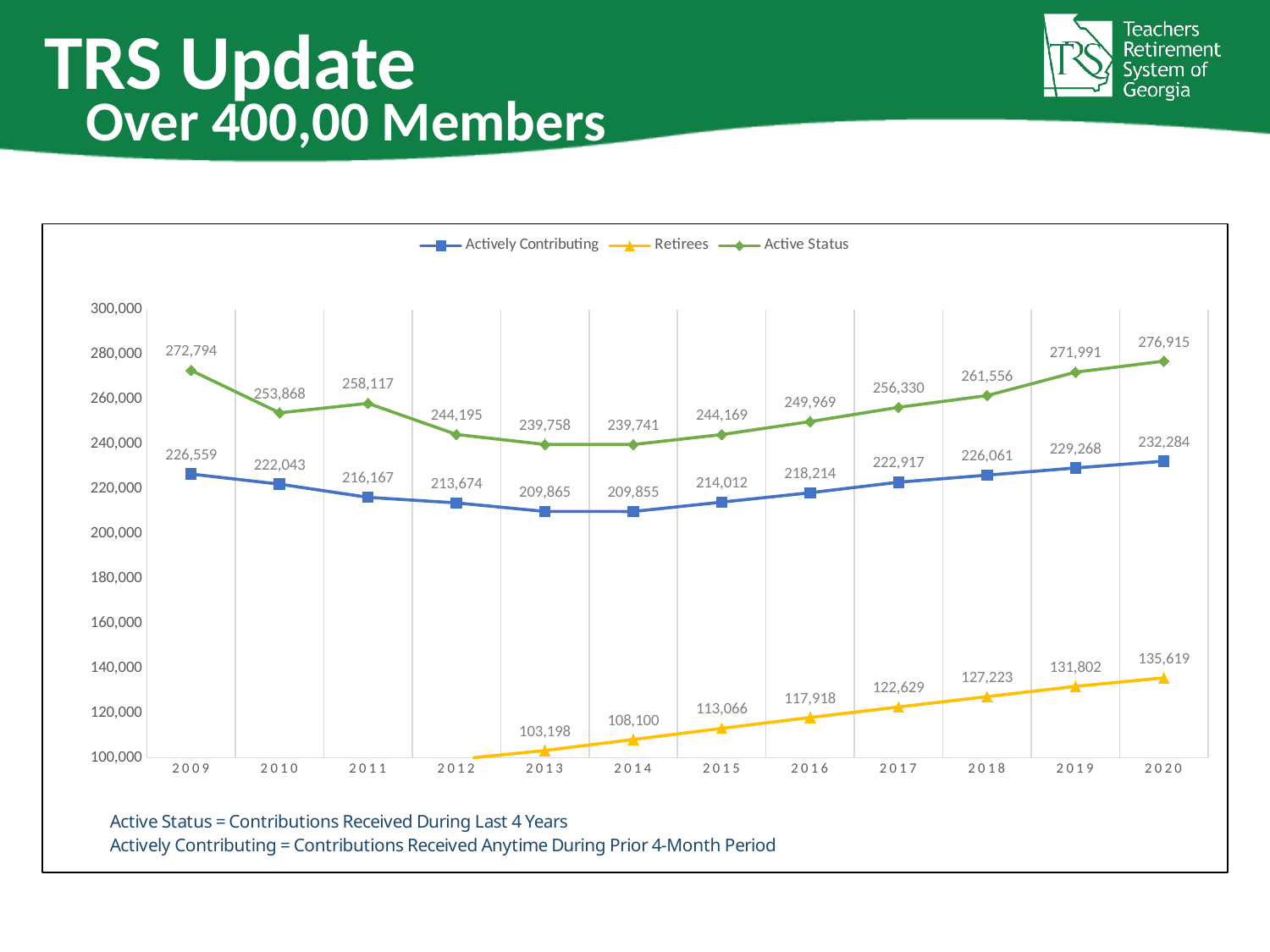
Does the Retirees series rise or fall from 2013 to 2020? Rise By how much did the Retirees value increase from 2013 to 2020? 32,421 In which labelled year is the Retirees series at its highest? 2020 What is the Active Status value for 2020? 276,915 How many series does the legend list? 3 How many years are shown on the x axis? 12 What kind of chart is shown on the slide? Line chart What is the Actively Contributing value for 2013? 209,865 What is the difference between the Active Status values for 2020 and 2009? 4,121 In which year is the Active Status series at its highest? 2020 Which year has the larger Actively Contributing value, 2009 or 2020? 2020 What is the Retirees value for 2016? 117,918